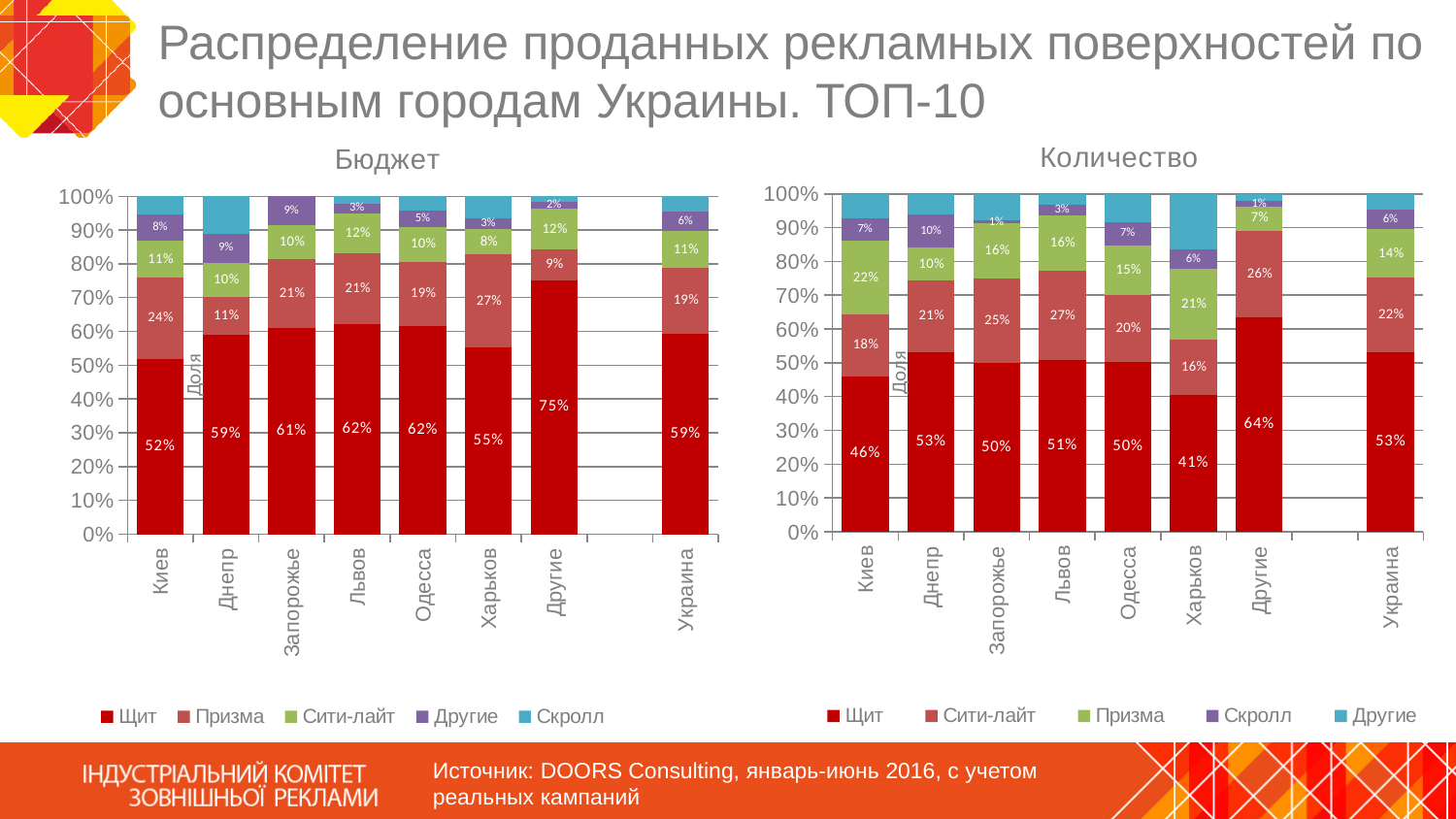
How many categories are shown on the x axis of the "Бюджет" chart? 8 In the "Бюджет" chart, what is the difference between the Щит share in Другие and in Киев? 23% In the "Количество" chart, what is the value for Сити-лайт in Львов? 27% In the "Бюджет" chart, what is the value for Призма in Харьков? 27% In the "Количество" chart, what is the value for Щит in Харьков? 41% In the "Бюджет" chart, what is the value for Щит in Киев? 52% What type of chart is the "Количество" chart? Stacked bar chart In the "Бюджет" chart, how many series does the legend list? 5 In the "Количество" chart, what is the value for Щит in Украина? 53% In the "Количество" chart, which is larger: the Призма share in Киев or in Днепр? Киев In the "Бюджет" chart, which city has the highest share for Щит? Другие In the "Количество" chart, which city has the lowest share for Щит? Харьков